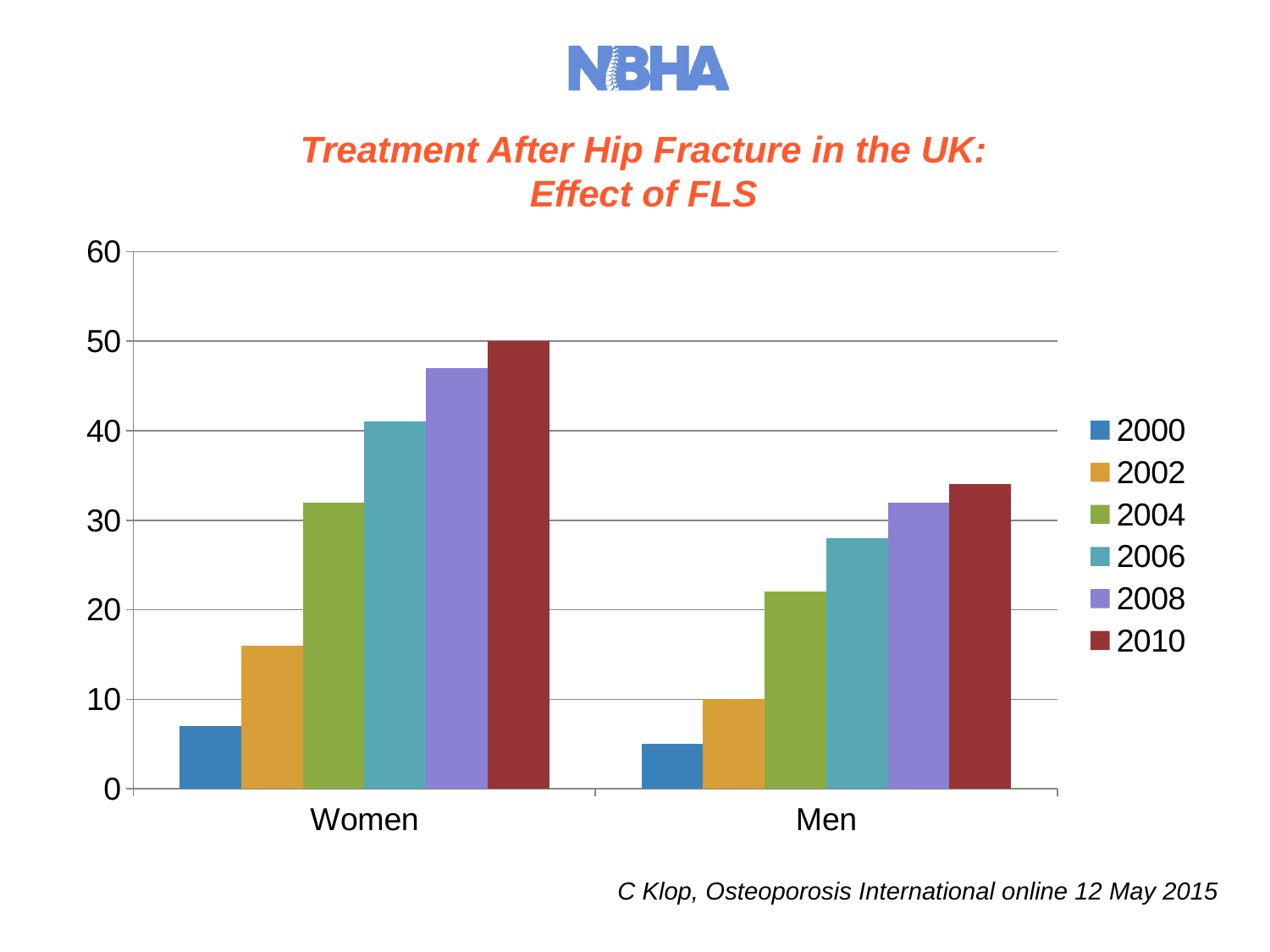
How many categories are shown on the x axis? 2 What is the value for Women in 2010? 50 Which category and year has the lowest bar in the chart? Men, 2000 What kind of chart is shown on the slide? Bar chart Is the value for Men in 2004 greater or less than 20? greater Do the values for Men rise or fall from 2000 to 2010? Rise Is the value for Men in 2000 greater or less than 10? less Is the value for Women in 2002 greater or less than 20? less Which category and year has the highest bar in the chart? Women, 2010 How many series does the legend list? 6 Which is larger, the 2008 value for Women or the 2008 value for Men? Women